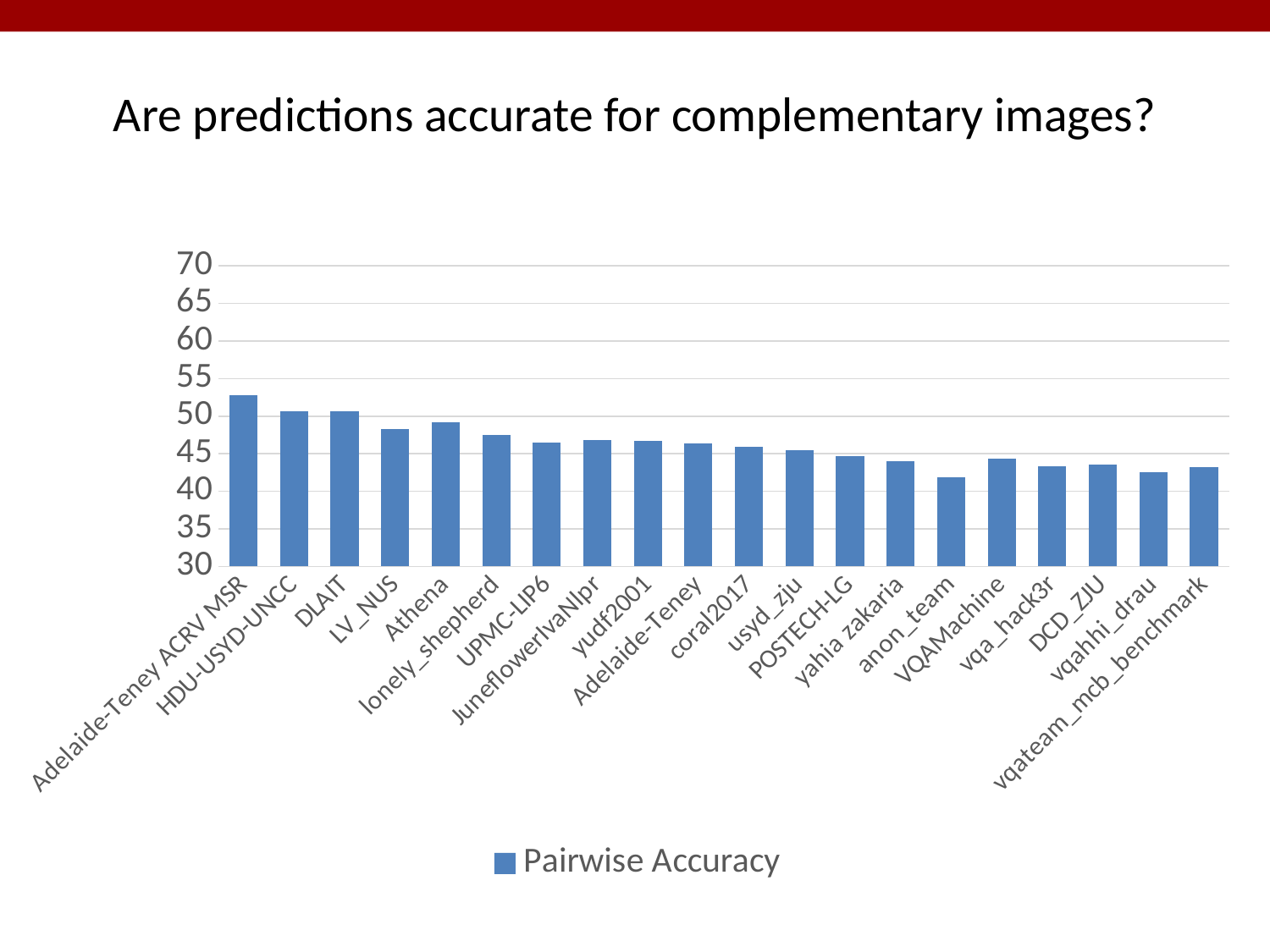
What kind of chart is shown on the slide? bar chart How many teams (categories) are plotted on the x axis? 20 Which team has the highest Pairwise Accuracy? Adelaide-Teney ACRV MSR What is the name of the series shown in the legend? Pairwise Accuracy Which has a higher Pairwise Accuracy, anon_team or VQAMachine? VQAMachine Which team has the lowest Pairwise Accuracy? anon_team Is the Pairwise Accuracy for anon_team greater or less than 45? less How many series does the legend list? 1 Is the Pairwise Accuracy for Adelaide-Teney ACRV MSR greater or less than 50? greater Is the Pairwise Accuracy for vqahhi_drau greater or less than 45? less Do the Pairwise Accuracy values generally rise or fall from left to right along the x axis? fall